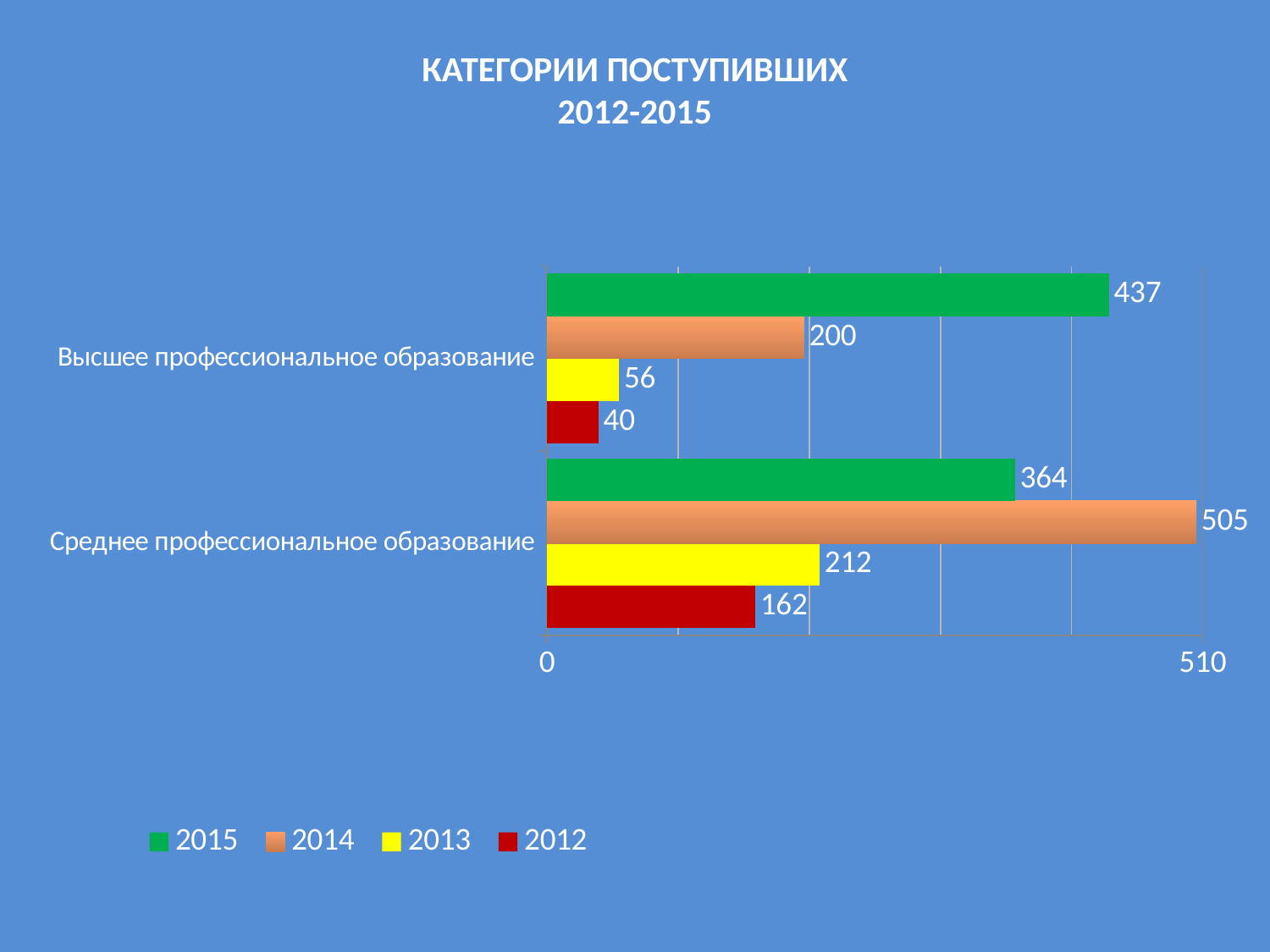
What is the difference between the 2013 and 2012 values for Среднее профессиональное образование? 50 Which year has the highest value in the Среднее профессиональное образование category? 2014 Which year has the lowest value in the Высшее профессиональное образование category? 2012 What kind of chart is shown on the slide? Bar chart What is the value for 2014 in the Высшее профессиональное образование category? 200 How many series does the legend list? 4 What is the value for 2012 in the Среднее профессиональное образование category? 162 What is the title of the chart? КАТЕГОРИИ ПОСТУПИВШИХ 2012-2015 How many categories are shown on the vertical axis? 2 What is the difference between the 2015 and 2014 values for Высшее профессиональное образование? 237 What is the value for 2015 in the Высшее профессиональное образование category? 437 Which is larger: the 2015 value for Высшее профессиональное образование or the 2015 value for Среднее профессиональное образование? Высшее профессиональное образование